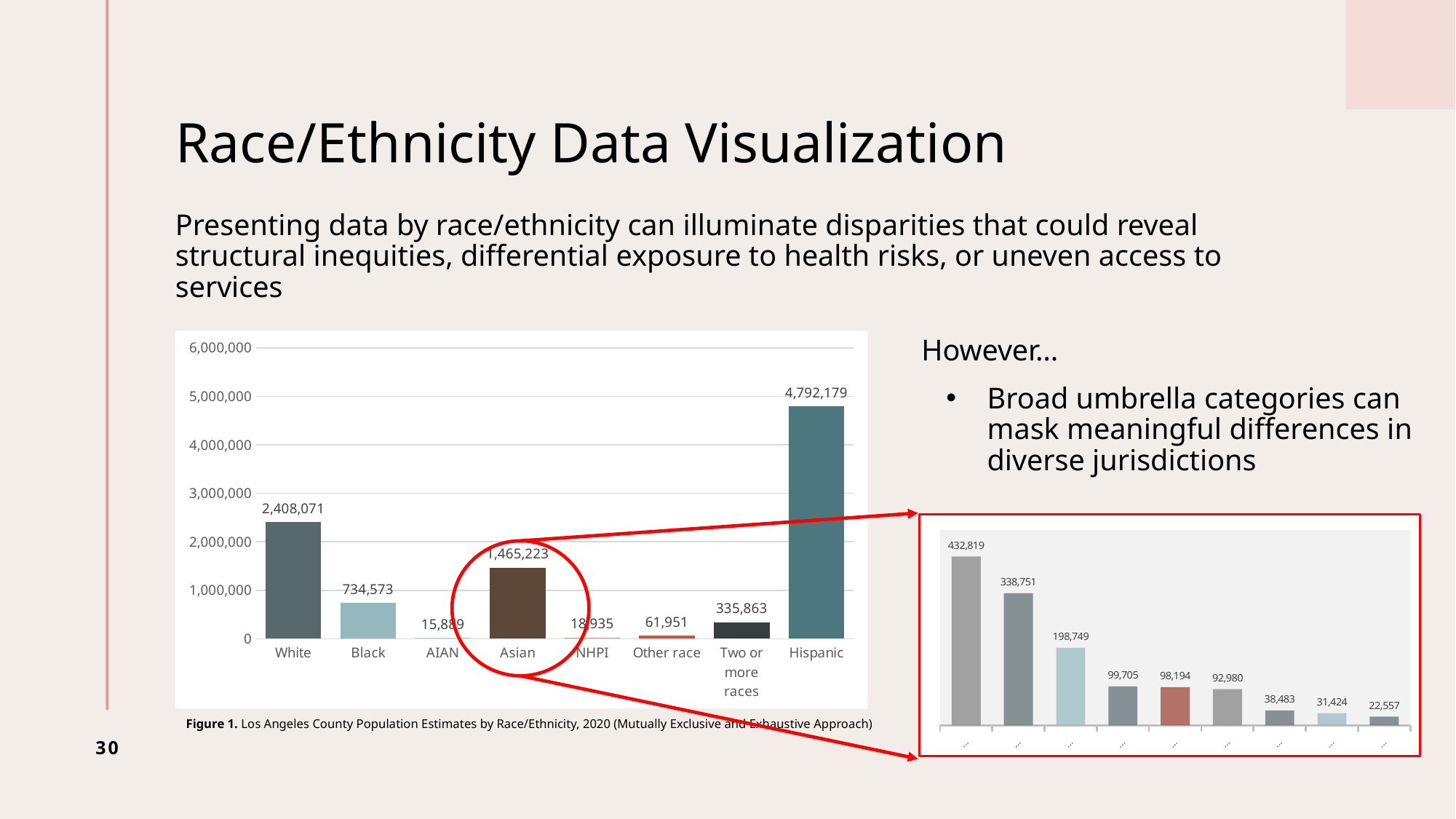
How many categories are shown in the Figure 1 chart on the left? 8 In the Figure 1 chart on the left, which category has the highest value? Hispanic In the inset chart on the right, what is the highest value shown? 432,819 In the inset chart on the right, what is the lowest value shown? 22,557 In the Figure 1 chart on the left, what is the value for Two or more races? 335,863 In the Figure 1 chart on the left, is the value for White greater or less than 2,000,000? greater In the Figure 1 chart on the left, what is the value for Asian? 1,465,223 In the Figure 1 chart on the left, what is the difference between the White and Black values? 1,673,498 How many bars are shown in the inset chart on the right? 9 In the Figure 1 chart on the left, what is the value for Hispanic? 4,792,179 In the Figure 1 chart on the left, which is larger, the value for Other race or the value for NHPI? Other race What kind of chart is Figure 1 on the left? bar chart